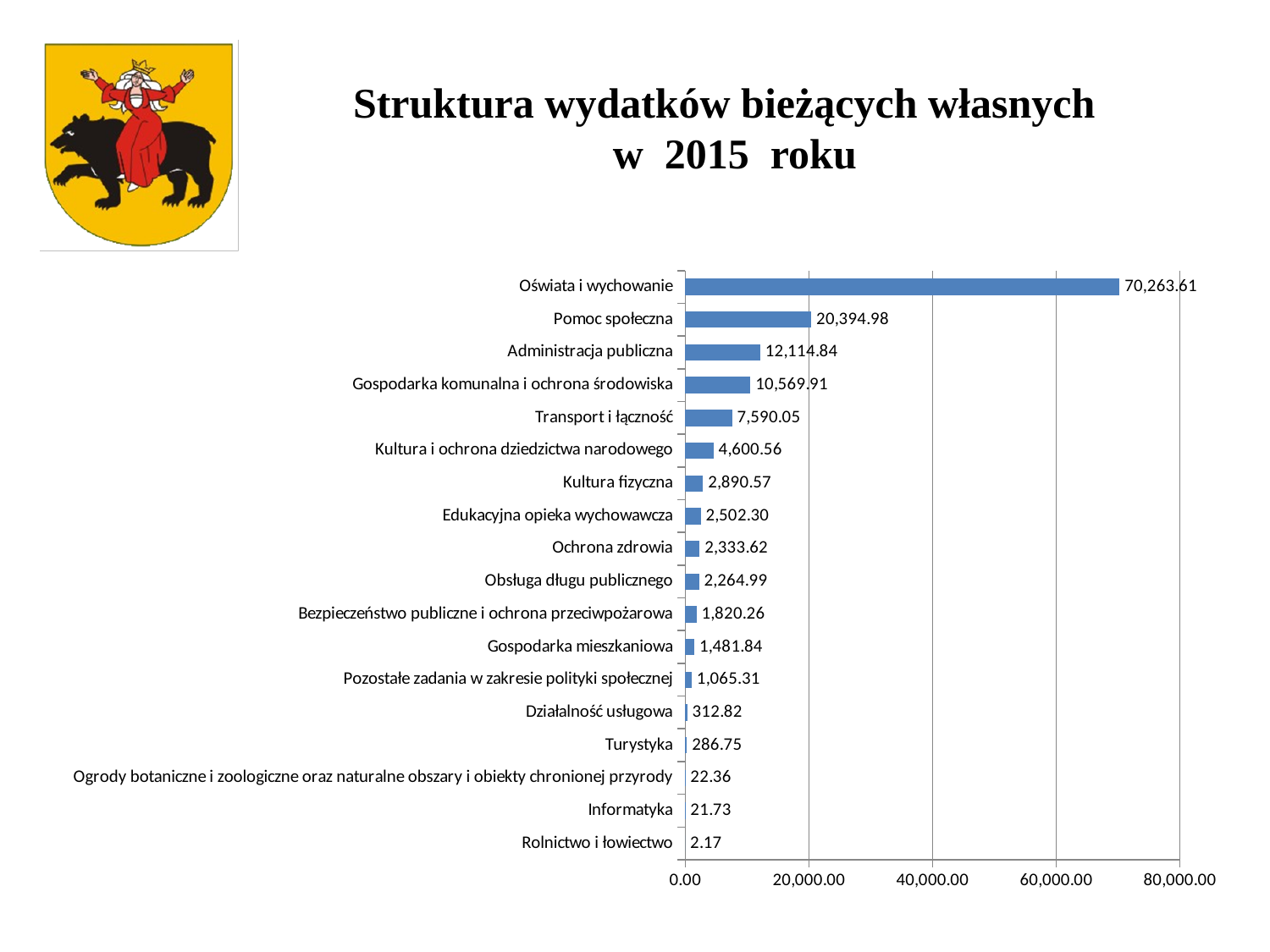
What is the value for Informatyka? 21.73 What is the difference between the values for Administracja publiczna and Gospodarka komunalna i ochrona środowiska? 1,544.93 What kind of chart is shown on the slide? bar chart Is the value for Pomoc społeczna greater or less than 20,000.00? greater Which category has the lowest value? Rolnictwo i łowiectwo How many categories are shown in the chart? 18 Which is larger, the value for Kultura fizyczna or the value for Ochrona zdrowia? Kultura fizyczna Which category has the highest value? Oświata i wychowanie What is the value for Oświata i wychowanie? 70,263.61 What is the value for Gospodarka mieszkaniowa? 1,481.84 What is the difference between the values for Oświata i wychowanie and Pomoc społeczna? 49,868.63 What is the value for Transport i łączność? 7,590.05